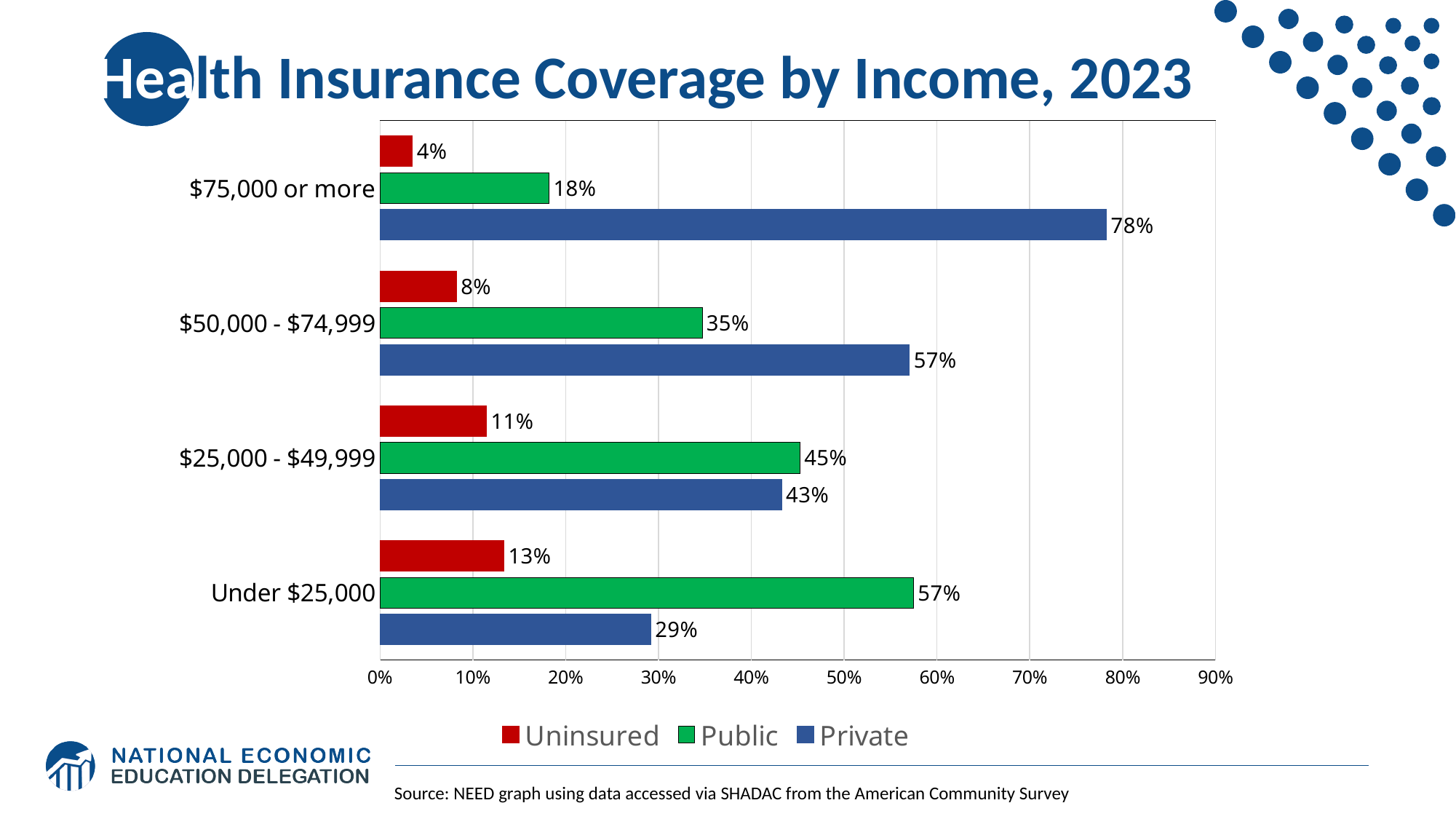
What is the difference between the Uninsured rates of the Under $25,000 group and the $75,000 or more group? 9% How many income groups are shown on the chart? 4 Which colour represents the Public series in the legend? Green For the $25,000 - $49,999 group, which is larger: Public or Private coverage? Public How many series does the legend list? 3 Which income group has the highest Uninsured rate? Under $25,000 Which income group has the lowest Private coverage rate? Under $25,000 What is the Public coverage rate for the $50,000 - $74,999 income group? 35% What is the difference between the Public and Private coverage rates for the Under $25,000 group? 28% What kind of chart is shown on the slide? Bar chart What is the Private coverage rate for the $75,000 or more income group? 78% What is the Uninsured rate for the Under $25,000 income group? 13%